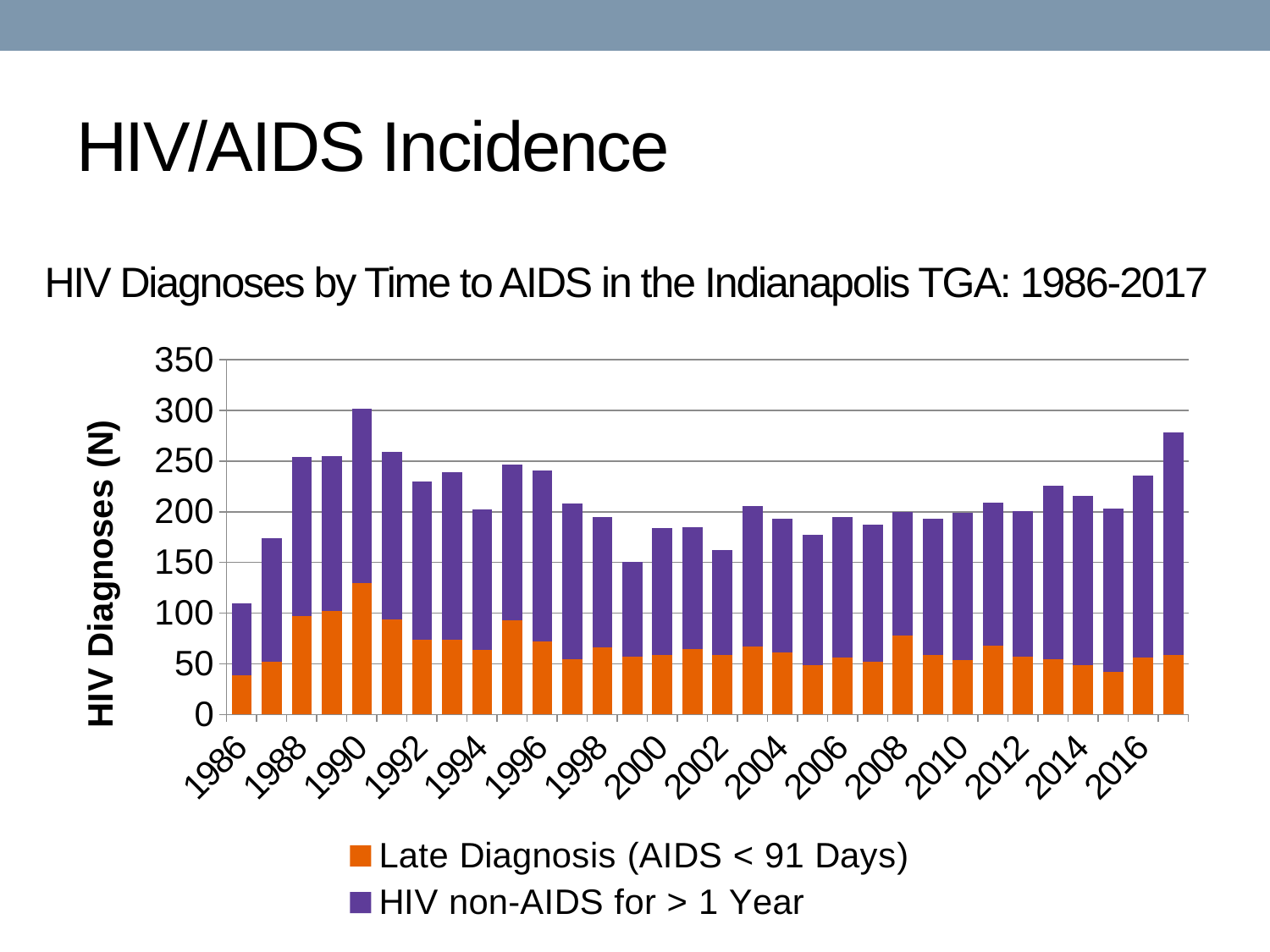
Which year has a taller total bar, 1990 or 2017? 1990 Is the total value for 2017 greater or less than 250? greater Which year has the highest total HIV diagnoses? 1990 Is the total value for 1990 greater or less than 250? greater Do total HIV diagnoses rise or fall from 1986 to 1990? rise What kind of chart is shown on the slide? Stacked bar chart How many years (bars) are plotted in the chart? 32 What is the label of the y axis? HIV Diagnoses (N) How many series does the legend list? 2 Is the Late Diagnosis (AIDS < 91 Days) value for 1990 greater or less than 100? greater Which year has the lowest total HIV diagnoses? 1986